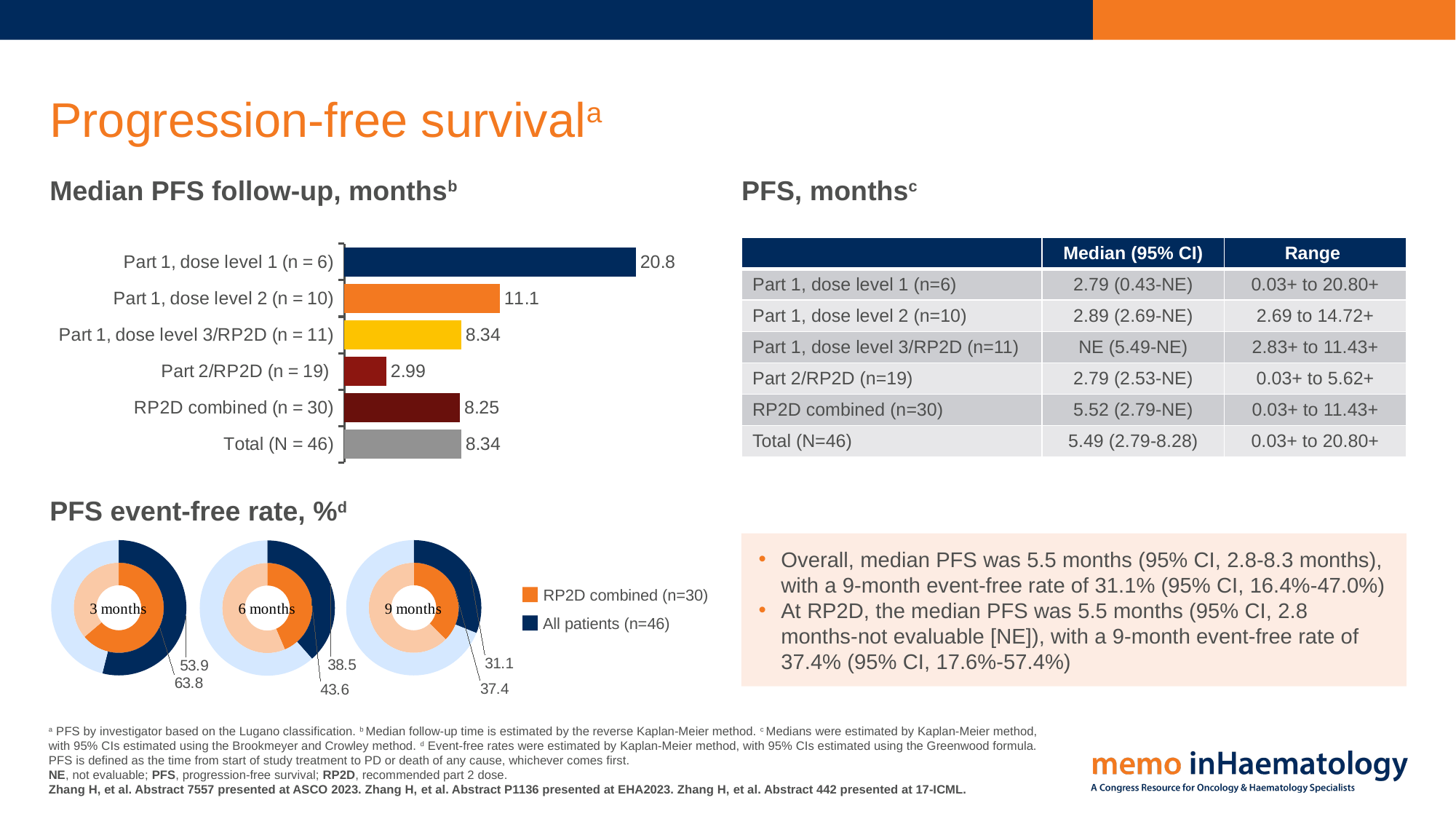
In the 'Median PFS follow-up, months' bar chart, which category has the lowest value? Part 2/RP2D (n = 19) In the 'Median PFS follow-up, months' bar chart, what is the value for Part 2/RP2D (n = 19)? 2.99 In the 'Median PFS follow-up, months' bar chart, what is the difference between Part 1, dose level 1 and Part 1, dose level 2? 9.7 In the 'Median PFS follow-up, months' bar chart, which category has the highest value? Part 1, dose level 1 (n = 6) In the 'Median PFS follow-up, months' bar chart, what is the value for Part 1, dose level 1 (n = 6)? 20.8 In the 'PFS event-free rate, %' charts, what is the 9-month event-free rate for RP2D combined (n=30)? 37.4 How many categories are shown in the 'Median PFS follow-up, months' bar chart? 6 In the 'Median PFS follow-up, months' bar chart, what is the value for RP2D combined (n = 30)? 8.25 What kind of chart is used for 'Median PFS follow-up, months'? Bar chart In the 'PFS event-free rate, %' charts, what is the 9-month event-free rate for All patients (n=46)? 31.1 In the 'Median PFS follow-up, months' bar chart, which is larger: Part 1, dose level 2 (n = 10) or Total (N = 46)? Part 1, dose level 2 (n = 10) How many series does the legend of the 'PFS event-free rate, %' charts list? 2